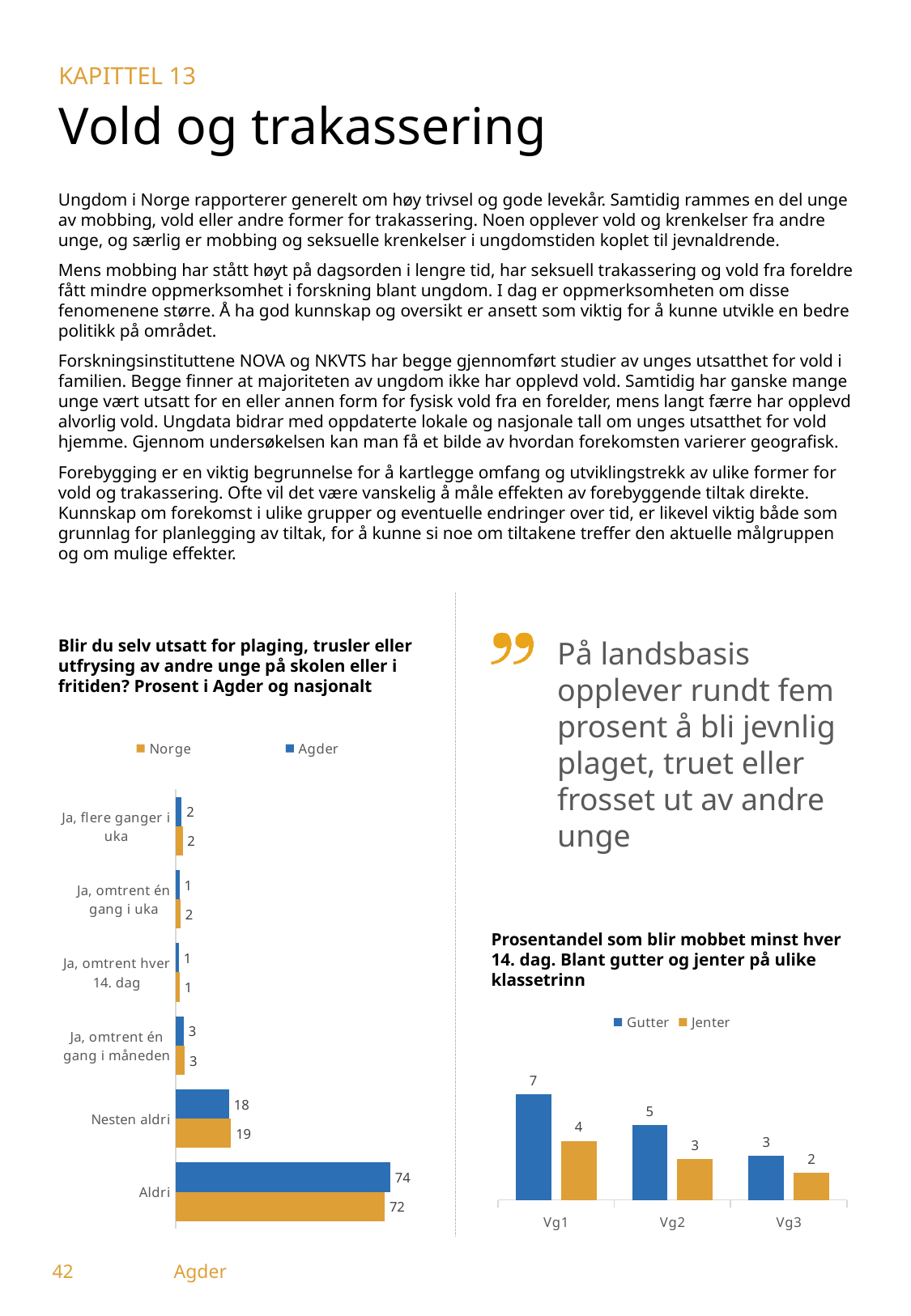
What kind of chart is the right chart (Prosentandel som blir mobbet minst hver 14. dag)? bar chart In the left chart (Blir du selv utsatt for plaging...), what is the difference between the Agder and Norge values for 'Aldri'? 2 In the left chart (Blir du selv utsatt for plaging...), how many categories are shown? 6 In the right chart (Prosentandel som blir mobbet minst hver 14. dag), what is the value for Jenter at Vg3? 2 In the right chart (Prosentandel som blir mobbet minst hver 14. dag), what is the value for Gutter at Vg1? 7 In the left chart (Blir du selv utsatt for plaging...), what is the value for Norge in the 'Nesten aldri' category? 19 In the right chart (Prosentandel som blir mobbet minst hver 14. dag), what is the difference between Gutter and Jenter at Vg2? 2 In the left chart (Blir du selv utsatt for plaging...), what is the value for Agder in the 'Aldri' category? 74 In the left chart (Blir du selv utsatt for plaging...), which category has the highest value for Agder? Aldri In the right chart (Prosentandel som blir mobbet minst hver 14. dag), do the Gutter values rise or fall from Vg1 to Vg3? fall In the left chart (Blir du selv utsatt for plaging...), how many series does the legend list? 2 In the left chart (Blir du selv utsatt for plaging...), which is larger for 'Nesten aldri': Agder or Norge? Norge